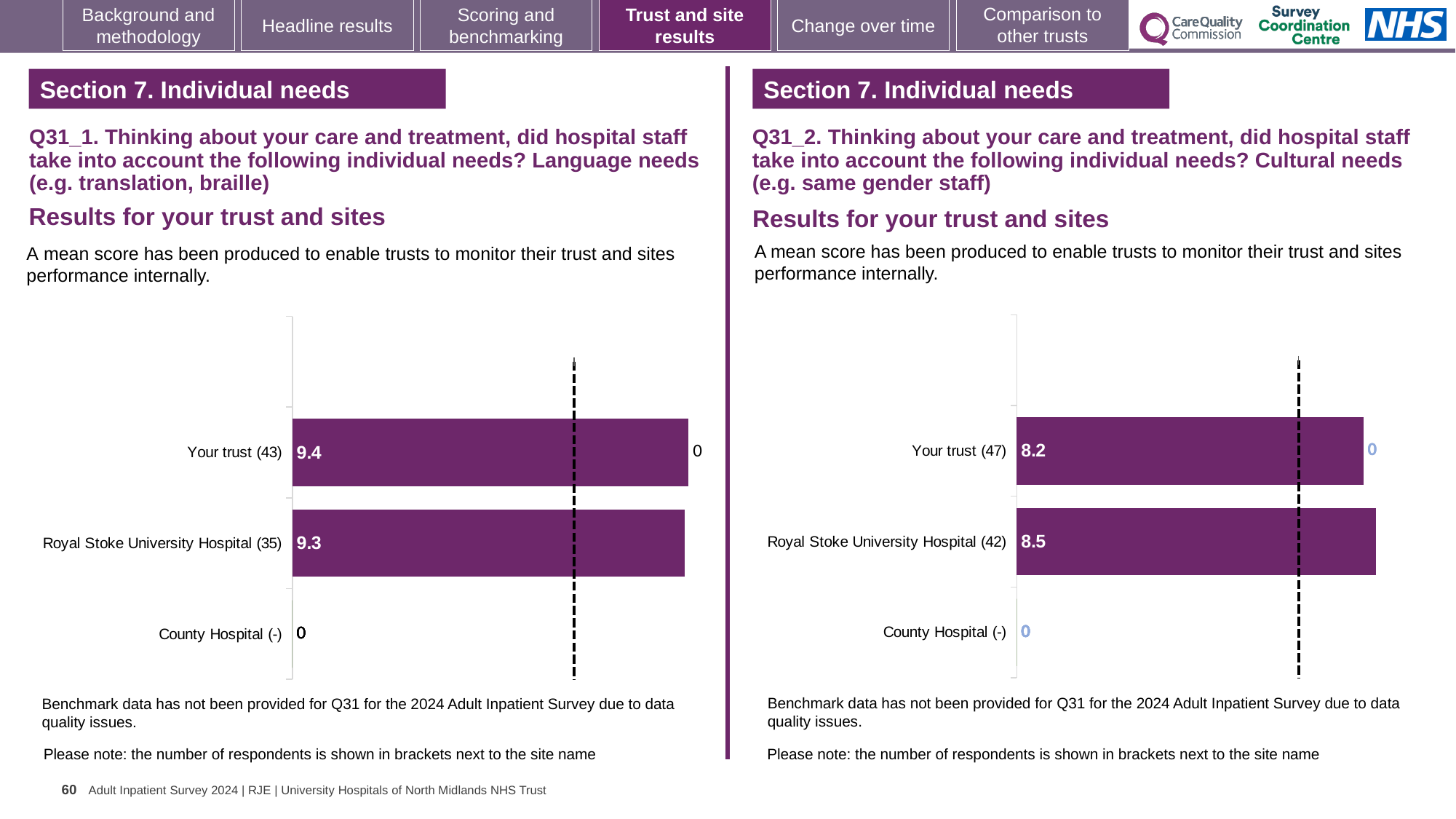
How many categories are shown on the left chart (Q31_1, Language needs)? 3 In the left chart (Q31_1, Language needs), what is the mean score for Royal Stoke University Hospital? 9.3 In the right chart (Q31_2, Cultural needs), what is the difference between the Royal Stoke University Hospital score and the Your trust score? 0.3 In the right chart (Q31_2, Cultural needs), what is the mean score for Your trust? 8.2 In the left chart (Q31_1, Language needs), what is the difference between the Your trust score and the Royal Stoke University Hospital score? 0.1 In the right chart (Q31_2, Cultural needs), which has the higher mean score: Your trust or Royal Stoke University Hospital? Royal Stoke University Hospital In the right chart (Q31_2, Cultural needs), what is the mean score for Royal Stoke University Hospital? 8.5 In the left chart (Q31_1, Language needs), what is the mean score for Your trust? 9.4 What type of chart is used on the right side of the slide (Q31_2, Cultural needs)? Bar chart In the right chart (Q31_2, Cultural needs), how many respondents are shown in brackets for Royal Stoke University Hospital? 42 In the left chart (Q31_1, Language needs), how many respondents are shown in brackets for Your trust? 43